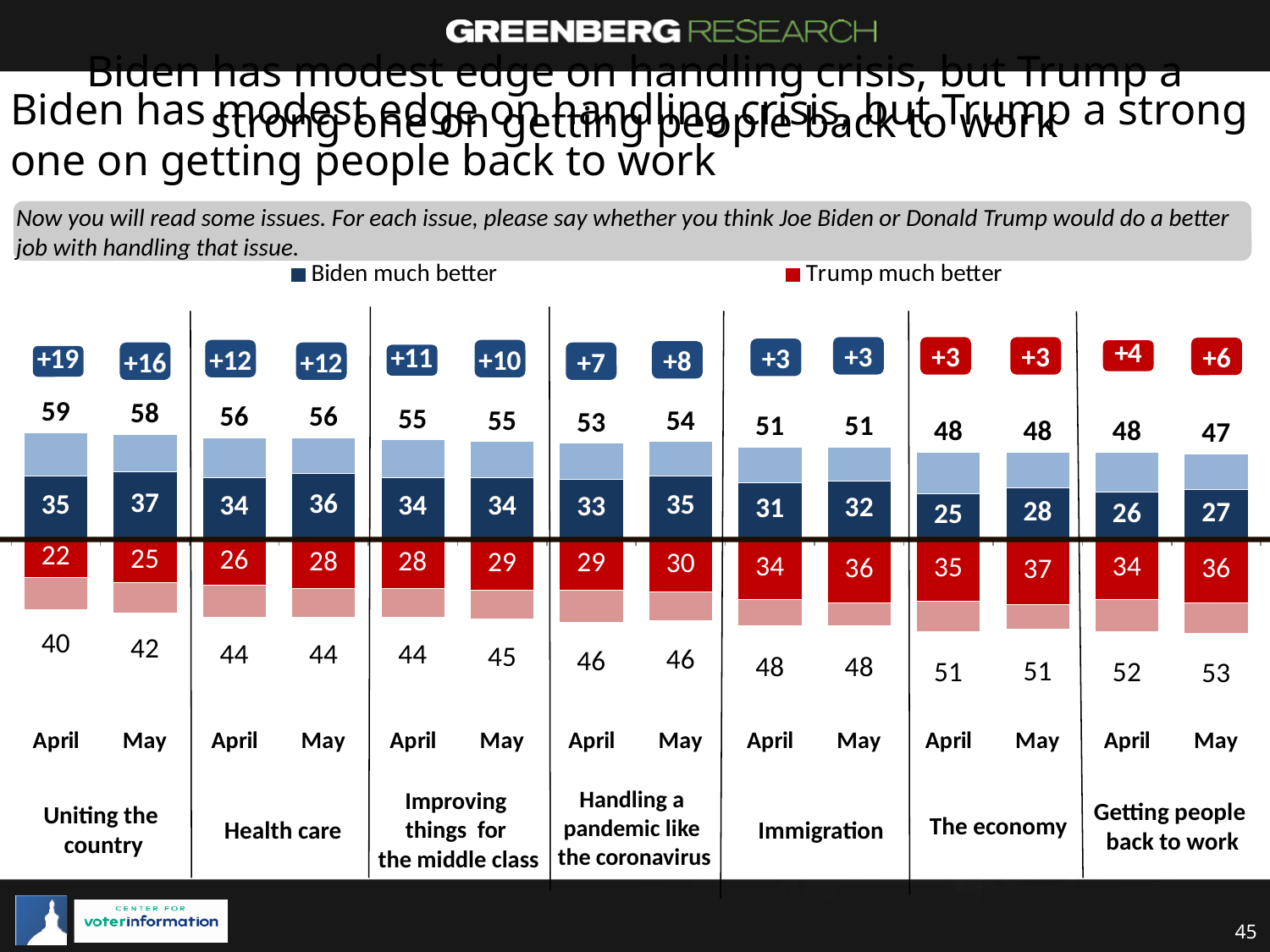
For Immigration in May, which is larger: 'Biden much better' or 'Trump much better'? Trump much better How many issues are shown on the chart? 7 How many series does the legend list? 2 What is the 'Trump much better' value for Health care in May? 28 What is the net margin shown for Getting people back to work in May? +6 What kind of chart is shown on the slide? Bar chart What is the total share saying Trump would do a better job on The economy in May? 51 What is the total share saying Biden would do a better job on Uniting the country in April? 59 Which issue has the lowest total Biden share in May? Getting people back to work Which issue has the highest total Biden share in May? Uniting the country Does the total Biden share for Uniting the country rise or fall from April to May? Fall For Uniting the country in April, what is the difference between the total Biden share (59) and the total Trump share (40)? 19